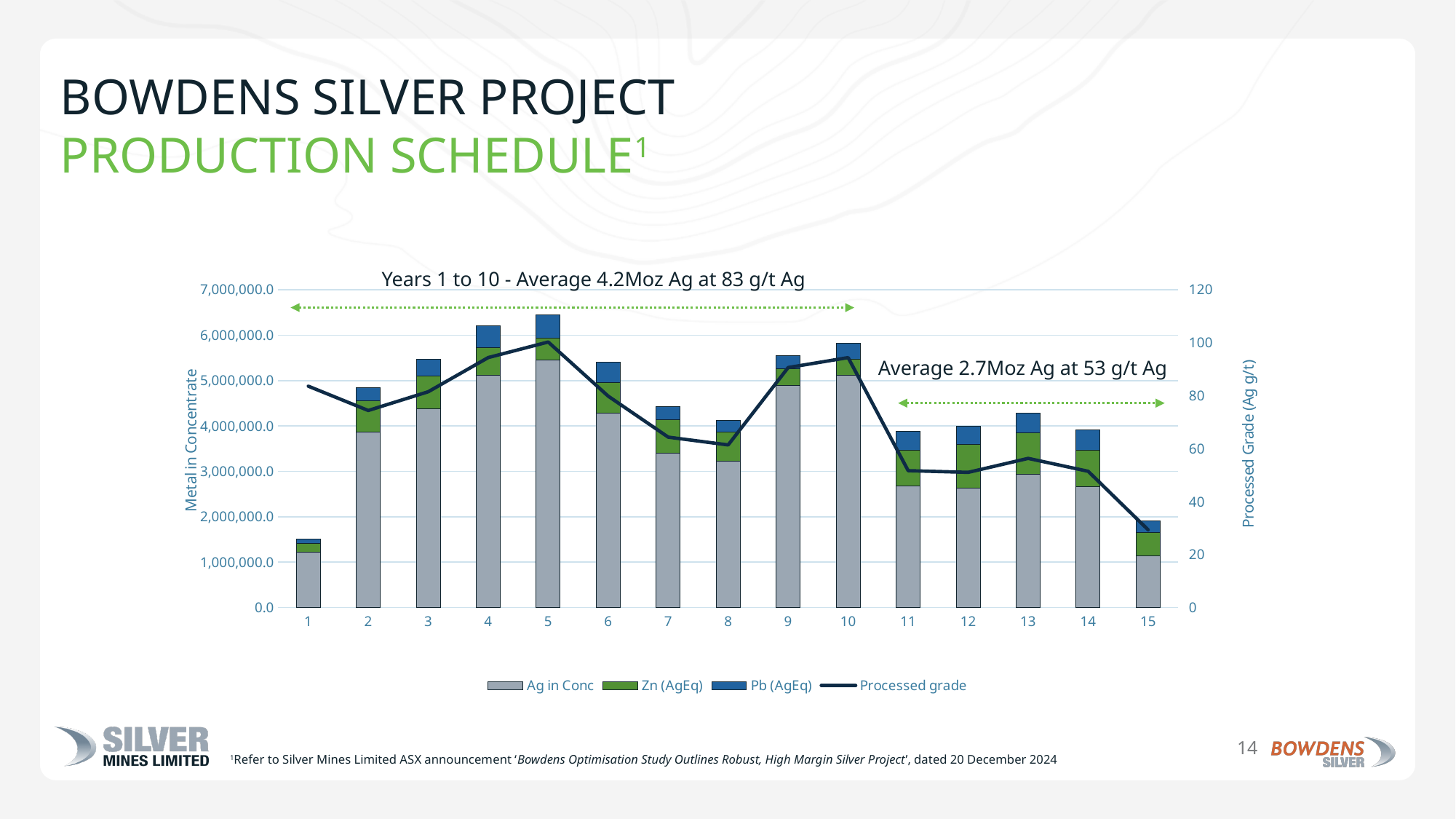
Is the processed grade for year 5 greater or less than 80 g/t? greater Is the total metal in concentrate for year 1 greater or less than 2,000,000? less What kind of chart is shown on the slide? Stacked bar chart with a line series What is the label of the right-hand vertical axis? Processed Grade (Ag g/t) Which year has the highest total metal in concentrate bar? 5 How many series does the chart legend list? 4 Is the processed grade for year 15 greater or less than 40 g/t? less Which year has the larger total metal in concentrate bar, year 4 or year 8? 4 How many years (categories) are shown on the x axis of the chart? 15 Which year has the lowest total metal in concentrate bar? 1 Does the processed grade line rise or fall from year 10 to year 15? fall